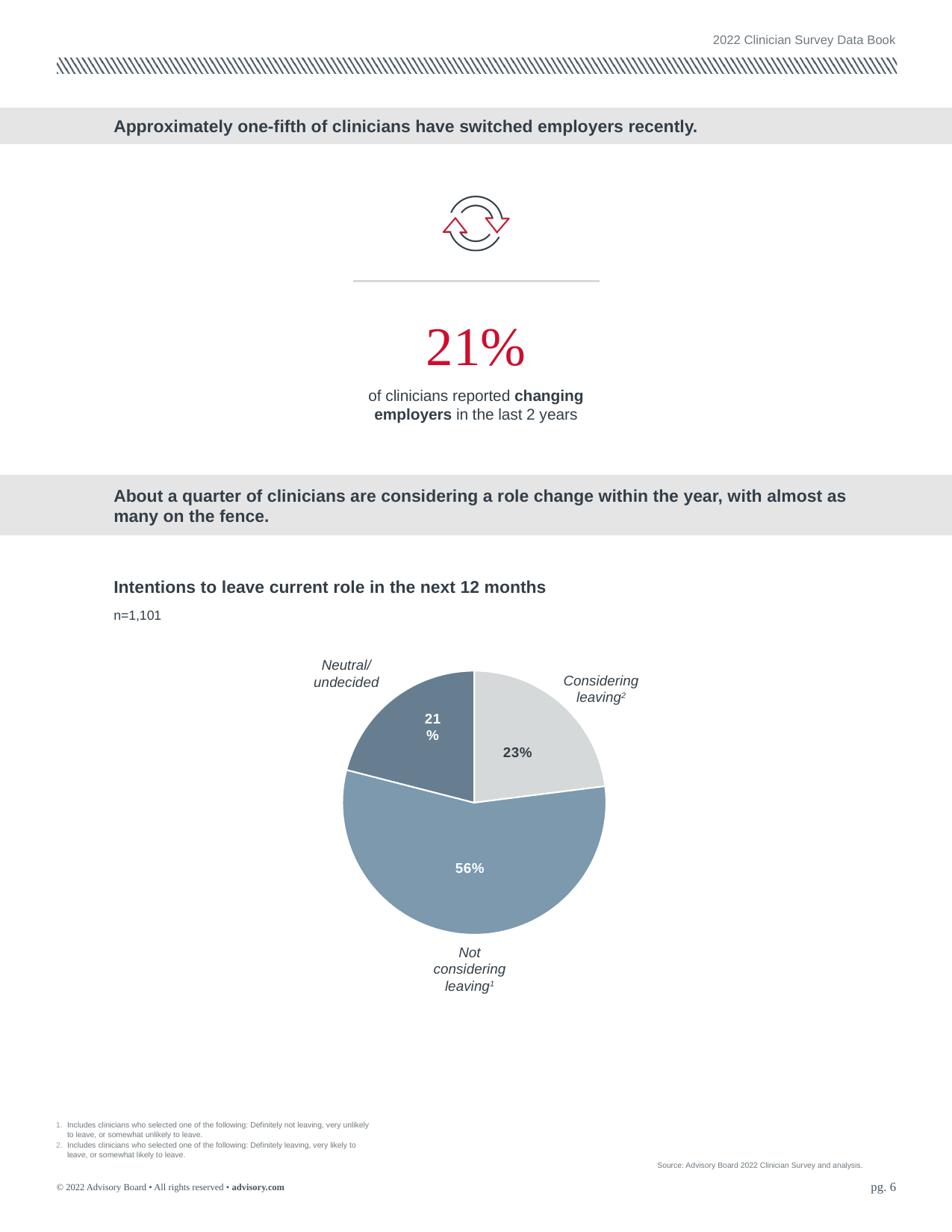
Which slice of the pie chart is the largest? Not considering leaving What kind of chart is used to show intentions to leave current role in the next 12 months? Pie chart What is the title of the pie chart? Intentions to leave current role in the next 12 months Which slice of the pie chart is the smallest? Neutral/undecided What share of clinicians are considering leaving their current role in the next 12 months? 23% What is the difference in percentage points between the 'Not considering leaving' slice and the 'Considering leaving' slice? 33 percentage points What share of clinicians are neutral/undecided about leaving their current role in the next 12 months? 21% What share of clinicians are not considering leaving their current role in the next 12 months? 56% What is the difference in percentage points between the 'Considering leaving' slice and the 'Neutral/undecided' slice? 2 percentage points How many slices does the pie chart have? 3 What is the sample size (n) shown for the pie chart? n=1,101 Which is larger in the pie chart: 'Considering leaving' or 'Neutral/undecided'? Considering leaving